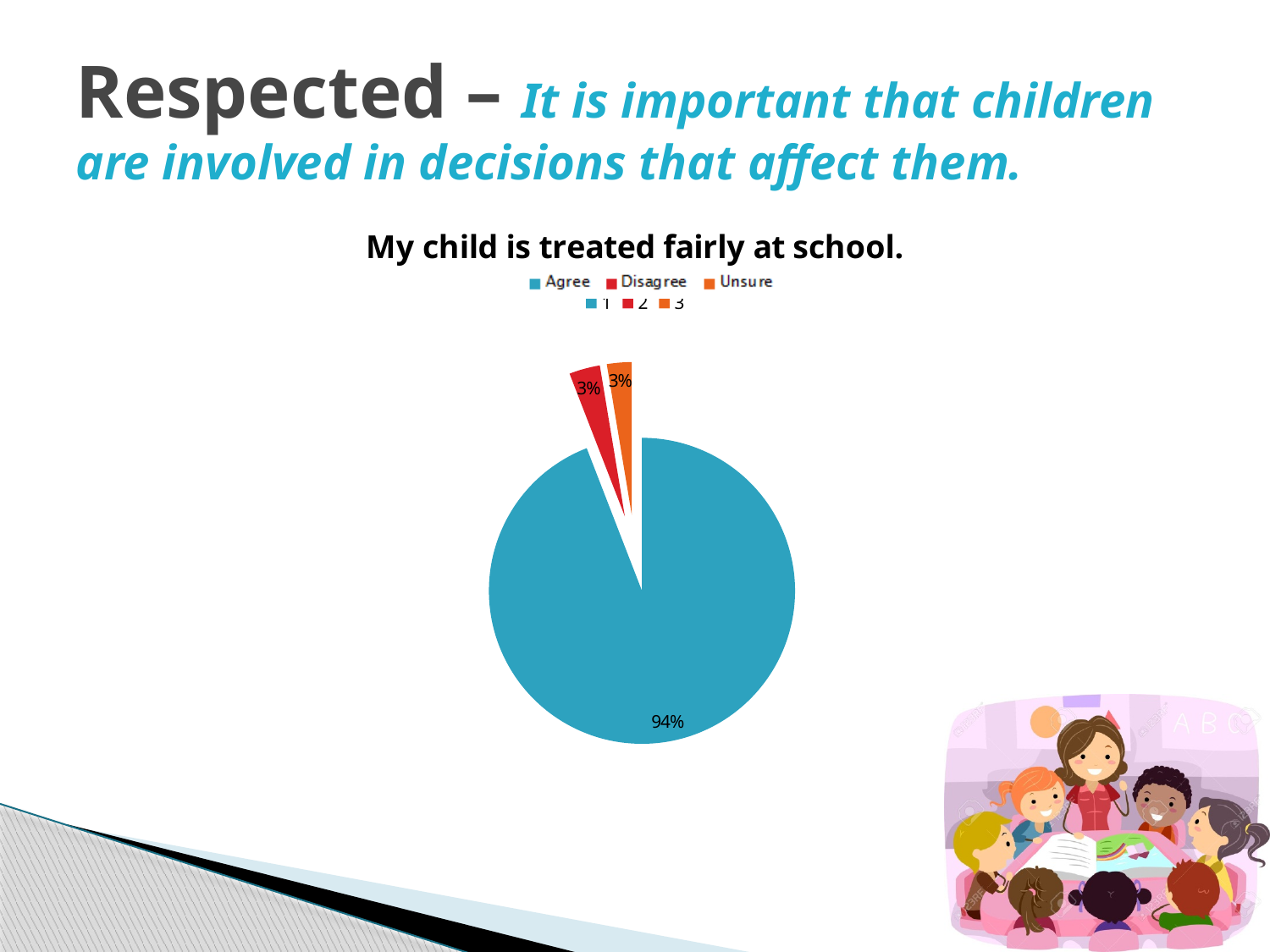
Which is larger, the Agree slice or the Unsure slice? Agree How many slices does the pie chart have? 3 What share of the pie is labelled Agree? 94% Which colour represents Agree in the pie chart? blue Which category has the largest slice of the pie? Agree What type of chart is shown on the slide? pie chart What is the title of the chart? My child is treated fairly at school. What share of the pie is labelled Unsure? 3% What is the combined share of the Disagree and Unsure slices? 6% Is the share for Agree greater or less than 90%? greater What share of the pie is labelled Disagree? 3% What is the difference between the Agree share and the Disagree share? 91%